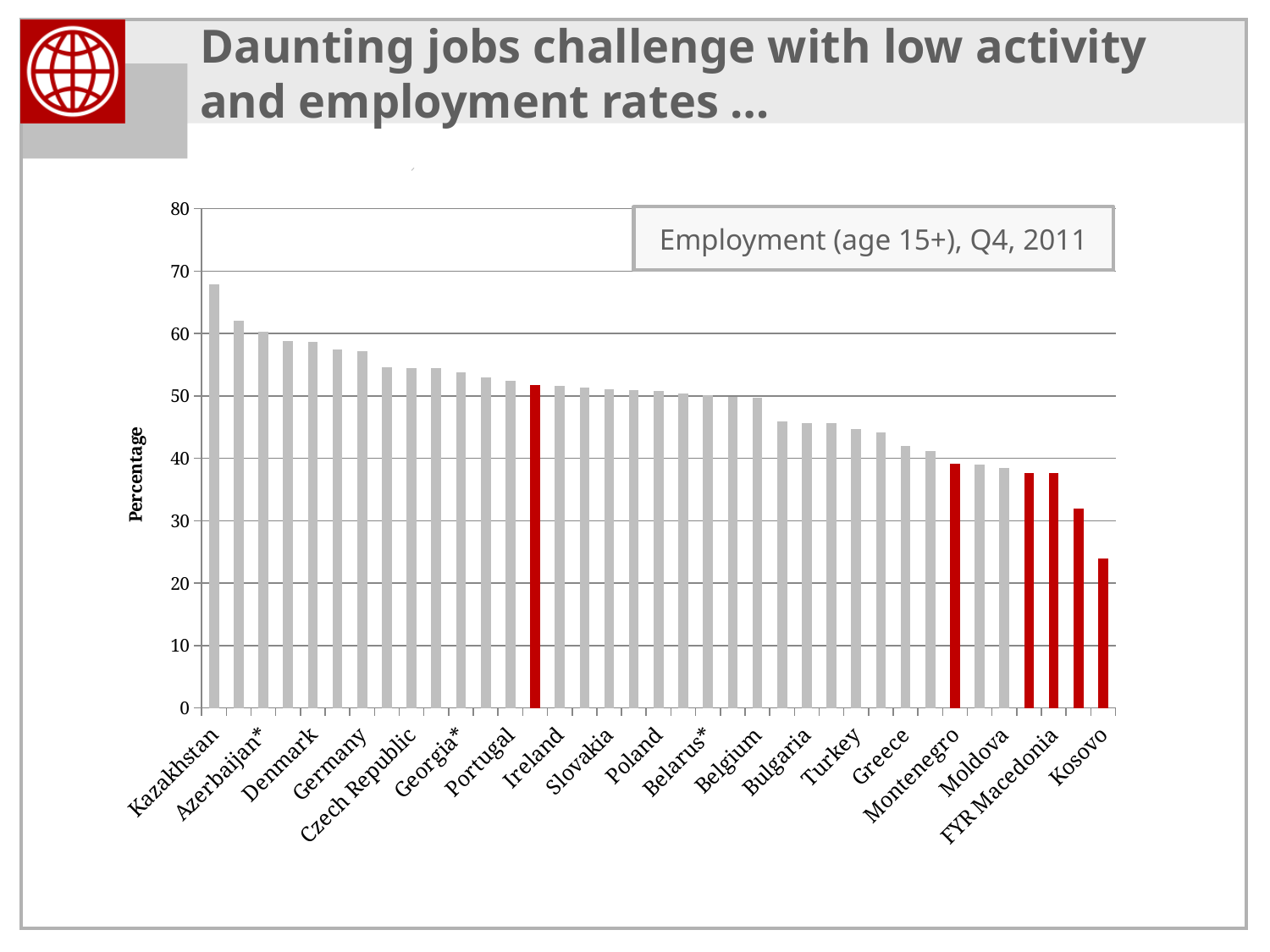
Is the value for Moldova greater or less than 40? less Which country has the lowest employment rate in the chart? Kosovo Is the value for Kosovo greater or less than 30? less Is the value for Turkey greater or less than 40? greater Do the employment rates rise or fall moving from left to right along the x axis? Fall Which country has the highest employment rate in the chart? Kazakhstan What is the label on the vertical axis of the chart? Percentage What kind of chart is shown on the slide? Bar chart What is the title shown in the box on the chart? Employment (age 15+), Q4, 2011 Which has a higher employment rate, Germany or Greece? Germany